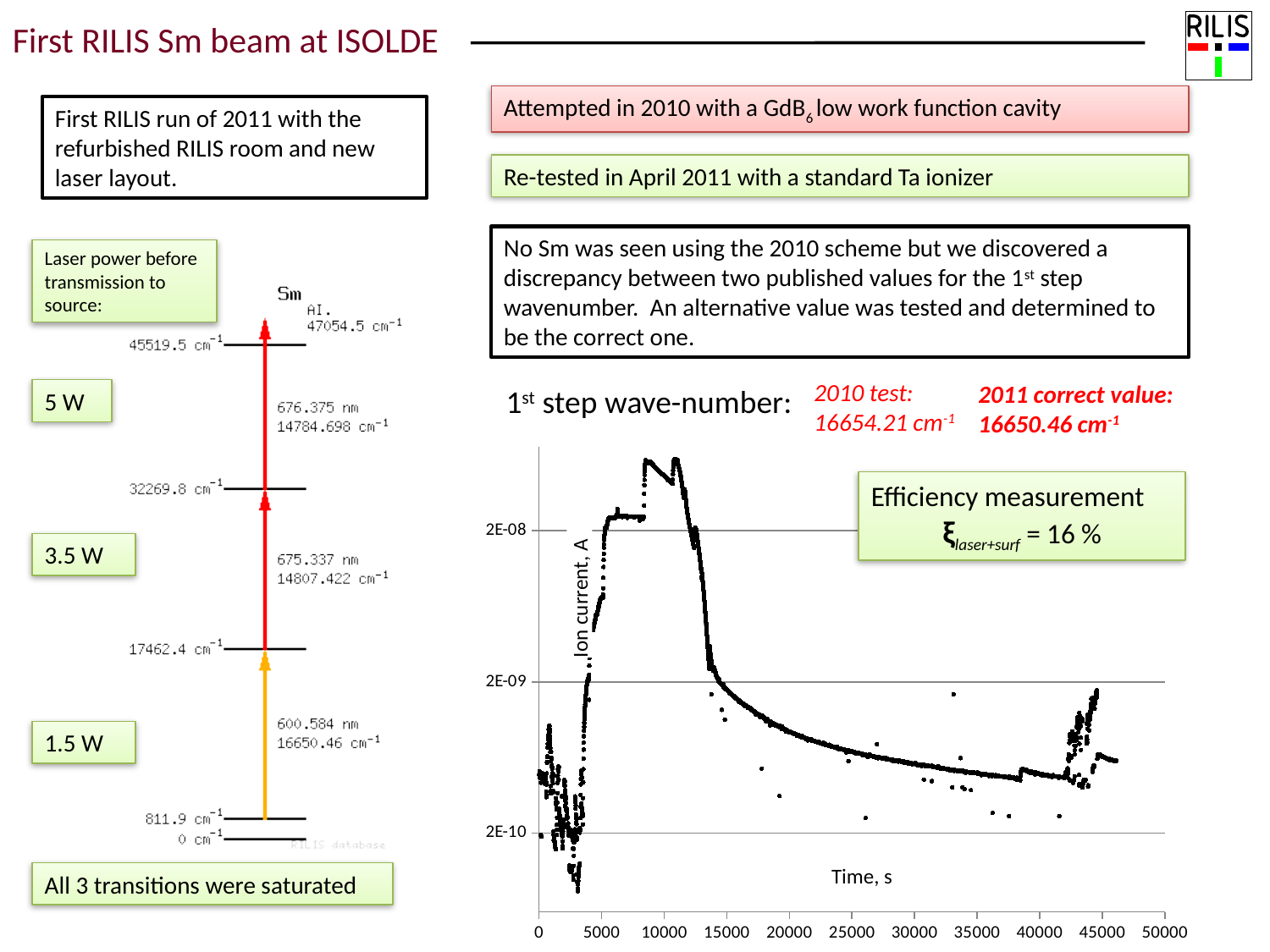
What is the label of the y axis of the ion current chart? Ion current, A On the ion current chart, is the ion current at a time of 10000 s greater or less than 2E-08? greater On the ion current chart, is the ion current at a time of 20000 s greater or less than 2E-09? less What is the label of the x axis of the ion current chart? Time, s On the ion current chart, is the ion current at a time of 30000 s greater or less than 2E-10? greater What is the largest value shown on the x axis of the ion current chart? 50000 On the ion current chart, does the ion current rise or fall between 15000 s and 40000 s? fall How many data series are plotted on the ion current chart? 1 What kind of chart is the ion current plot on the right of the slide? scatter chart